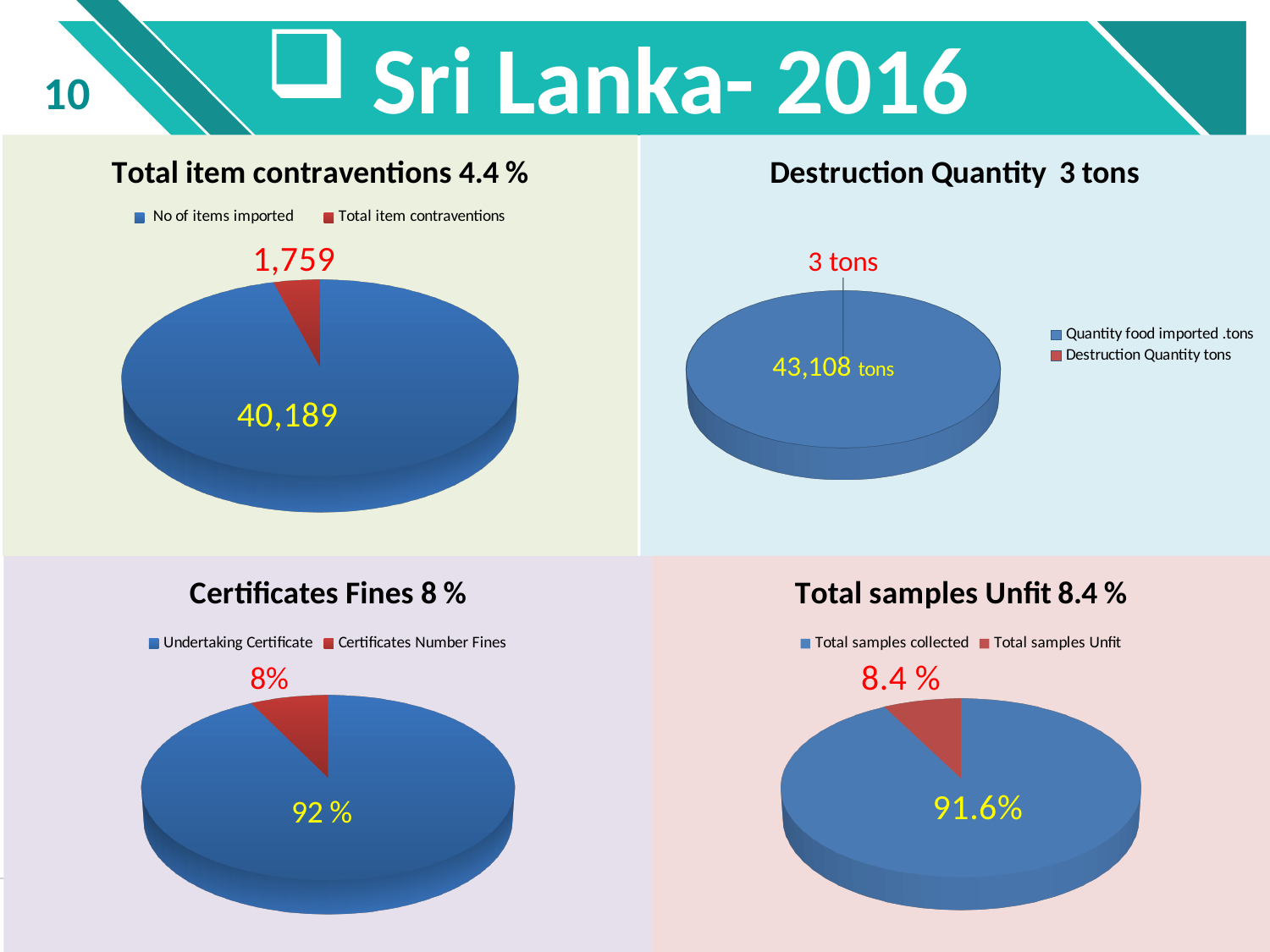
In the 'Destruction Quantity 3 tons' chart, what is the value for Destruction Quantity? 3 tons In the 'Destruction Quantity 3 tons' chart, what is the value for Quantity food imported? 43,108 tons In the 'Total item contraventions 4.4 %' chart, what is the value for No of items imported? 40,189 In the 'Total item contraventions 4.4 %' chart, what is the value for Total item contraventions? 1,759 How many entries does the legend of the 'Total samples Unfit 8.4 %' chart list? 2 In the 'Certificates Fines 8 %' chart, what is the value for Certificates Number Fines? 8% In the 'Total item contraventions 4.4 %' chart, what is the difference between No of items imported and Total item contraventions? 38,430 In the 'Certificates Fines 8 %' chart, what is the value for Undertaking Certificate? 92 % In the 'Total samples Unfit 8.4 %' chart, what is the value for Total samples collected? 91.6% In the 'Destruction Quantity 3 tons' chart, which slice is larger: Quantity food imported or Destruction Quantity? Quantity food imported In the 'Total samples Unfit 8.4 %' chart, which slice is the smallest? Total samples Unfit What kind of chart is the 'Total item contraventions 4.4 %' chart? pie chart